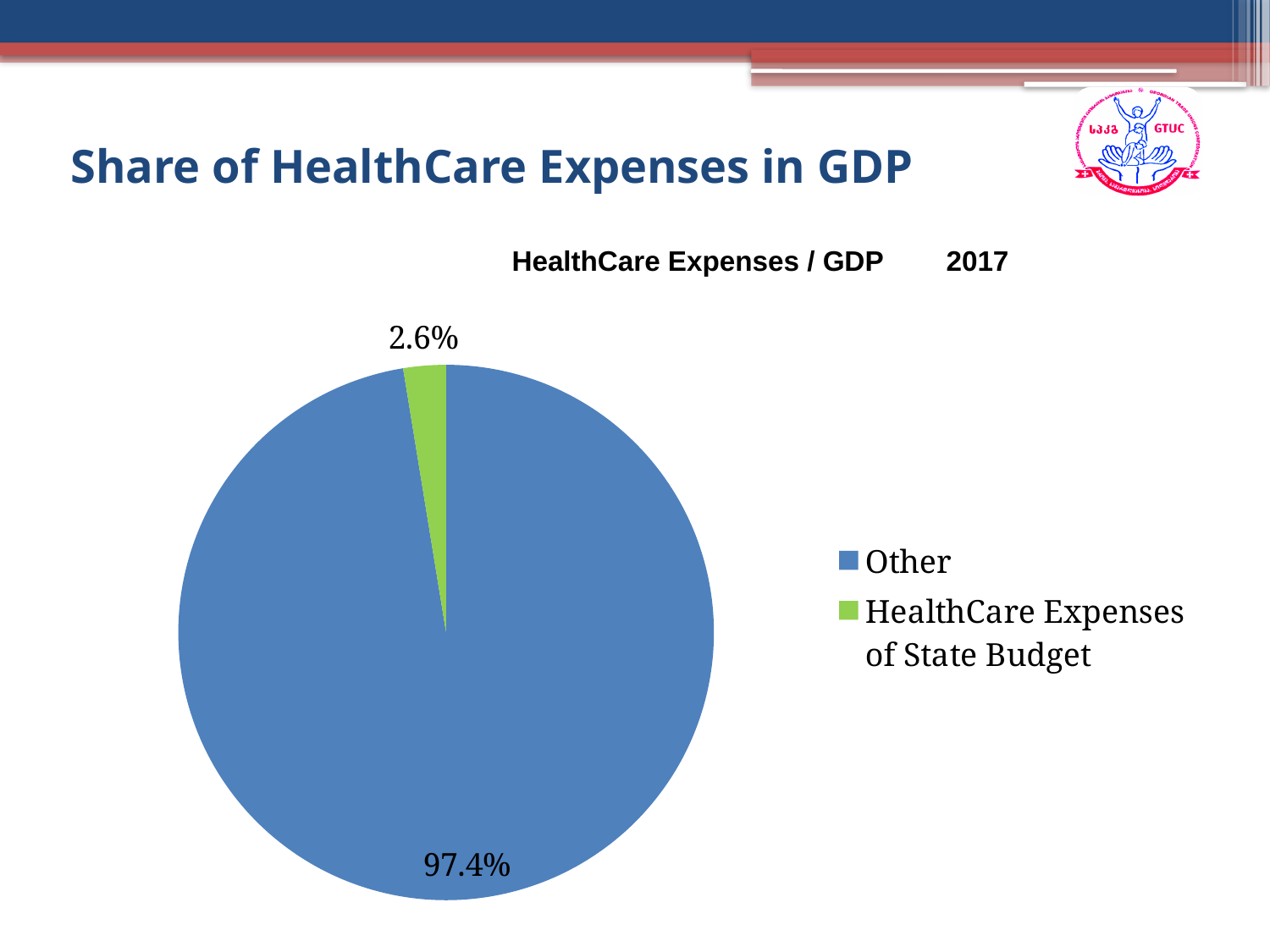
How many entries does the legend list? 2 Which is larger, the Other slice or the HealthCare Expenses of State Budget slice? Other What colour is the HealthCare Expenses of State Budget slice? green What is the value shown for the HealthCare Expenses of State Budget slice? 2.6% What share of the pie does the HealthCare Expenses of State Budget slice represent? 2.6% What is the title of the chart? HealthCare Expenses / GDP 2017 Which slice is the largest? Other What kind of chart is shown on the slide? pie chart What is the value shown for the Other slice? 97.4% How many slices does the pie chart have? 2 What is the difference between the Other slice and the HealthCare Expenses of State Budget slice? 94.8% Which slice is the smallest? HealthCare Expenses of State Budget